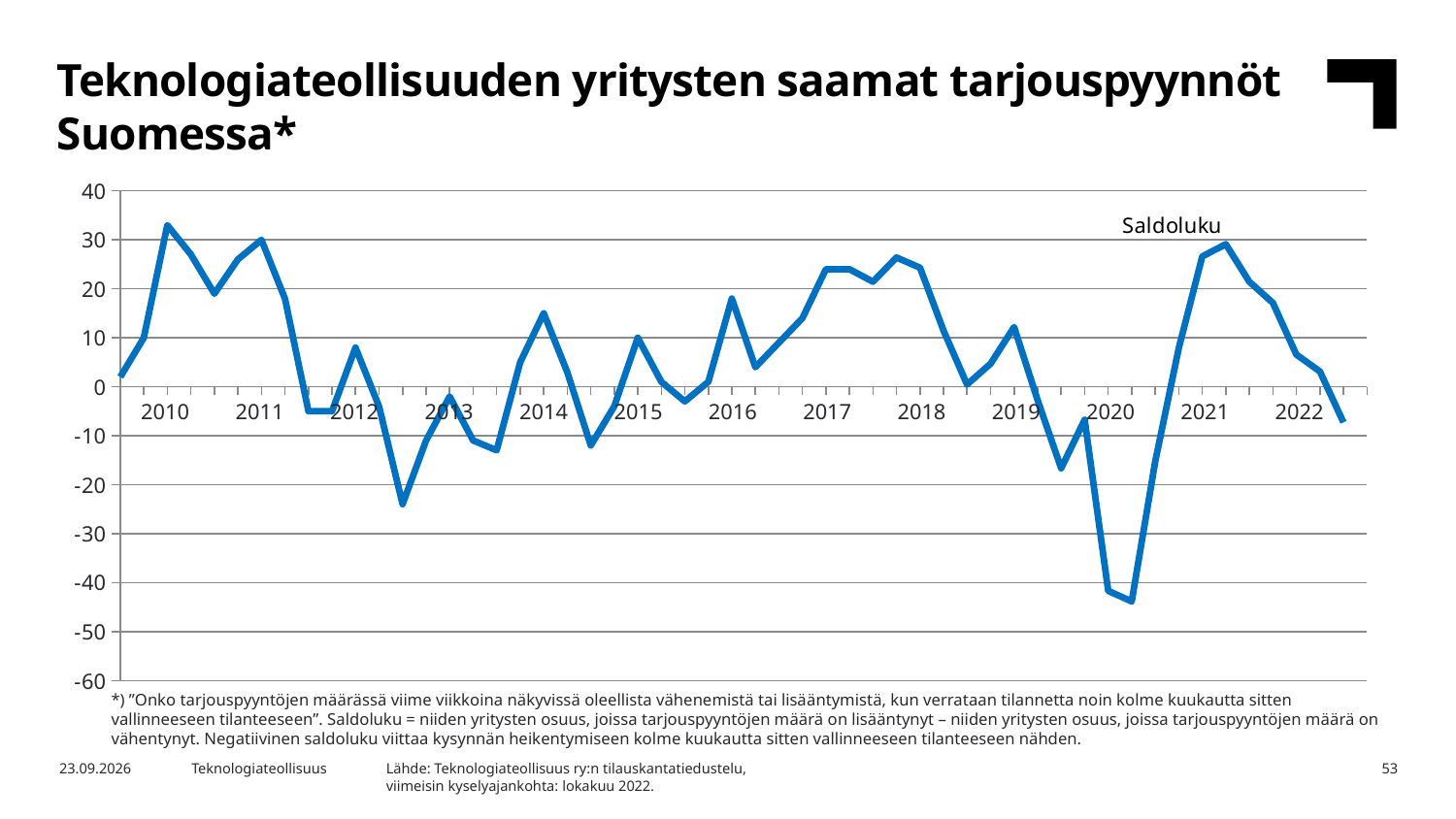
Is the peak value of the line in 2010 greater or less than 30? greater Does the line rise or fall from its 2021 peak to the end of 2022? fall How many years are labelled on the x axis? 13 Is the lowest value of the line in 2020 greater or less than -40? less In which year does the line reach its lowest value? 2020 What is the title of the chart on the slide? Teknologiateollisuuden yritysten saamat tarjouspyynnöt Suomessa* Is the lowest value of the line in 2012 greater or less than -20? less What is the name of the series plotted in the chart? Saldoluku In which year does the line reach its highest value? 2010 What kind of chart is shown on the slide? line chart How many series does the chart show? 1